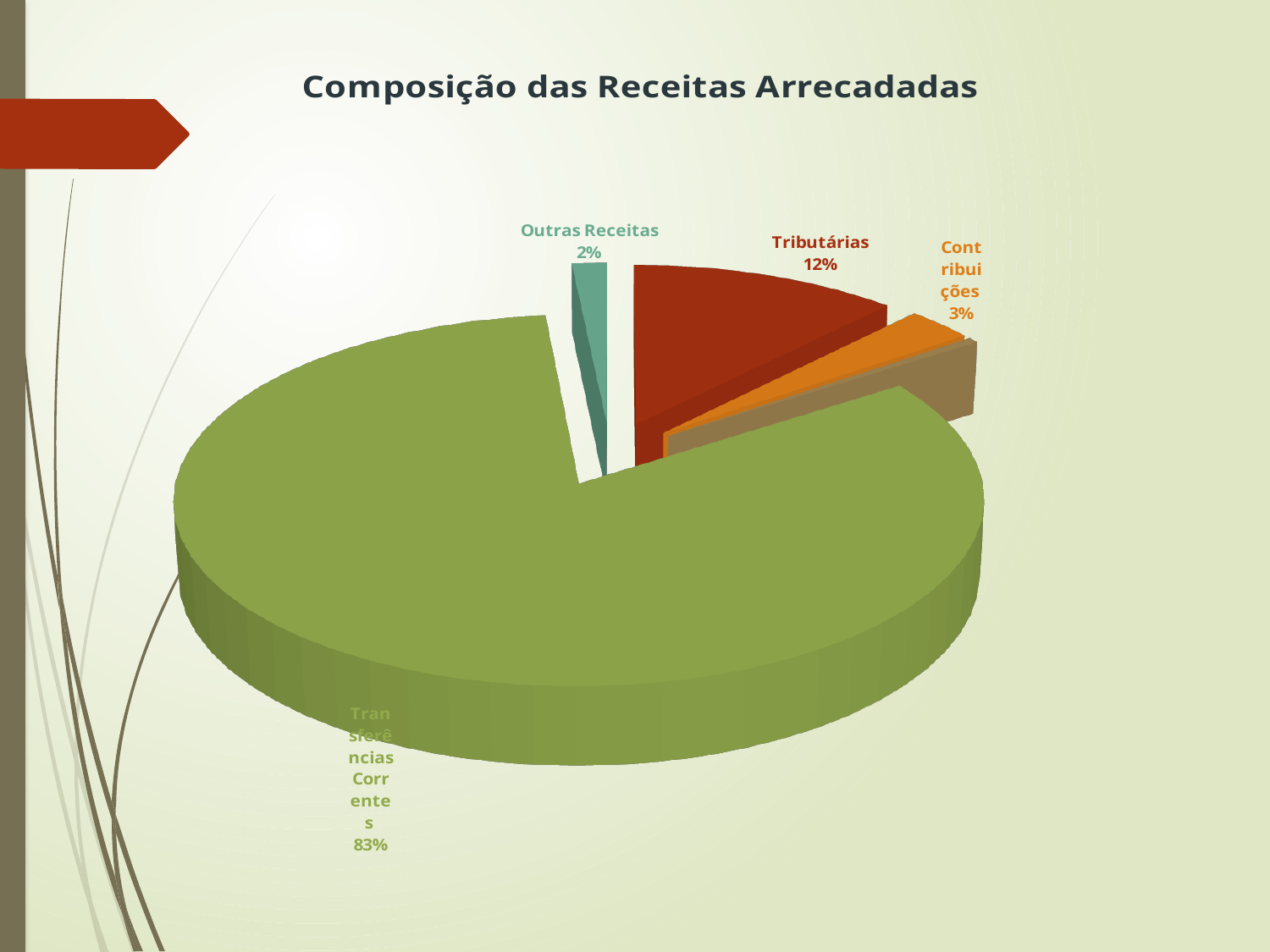
Which is larger, the share for Tributárias or the share for Contribuições? Tributárias What share of the pie does Outras Receitas represent? 2% What share of the pie does Transferências Correntes represent? 83% Which category has the largest slice of the pie? Transferências Correntes What is the title of the chart? Composição das Receitas Arrecadadas What is the difference in percentage points between Tributárias and Contribuições? 9 What share of the pie does Tributárias represent? 12% What colour is the Transferências Correntes slice? green How many slices does the pie chart have? 5 What kind of chart is shown on the slide? pie chart